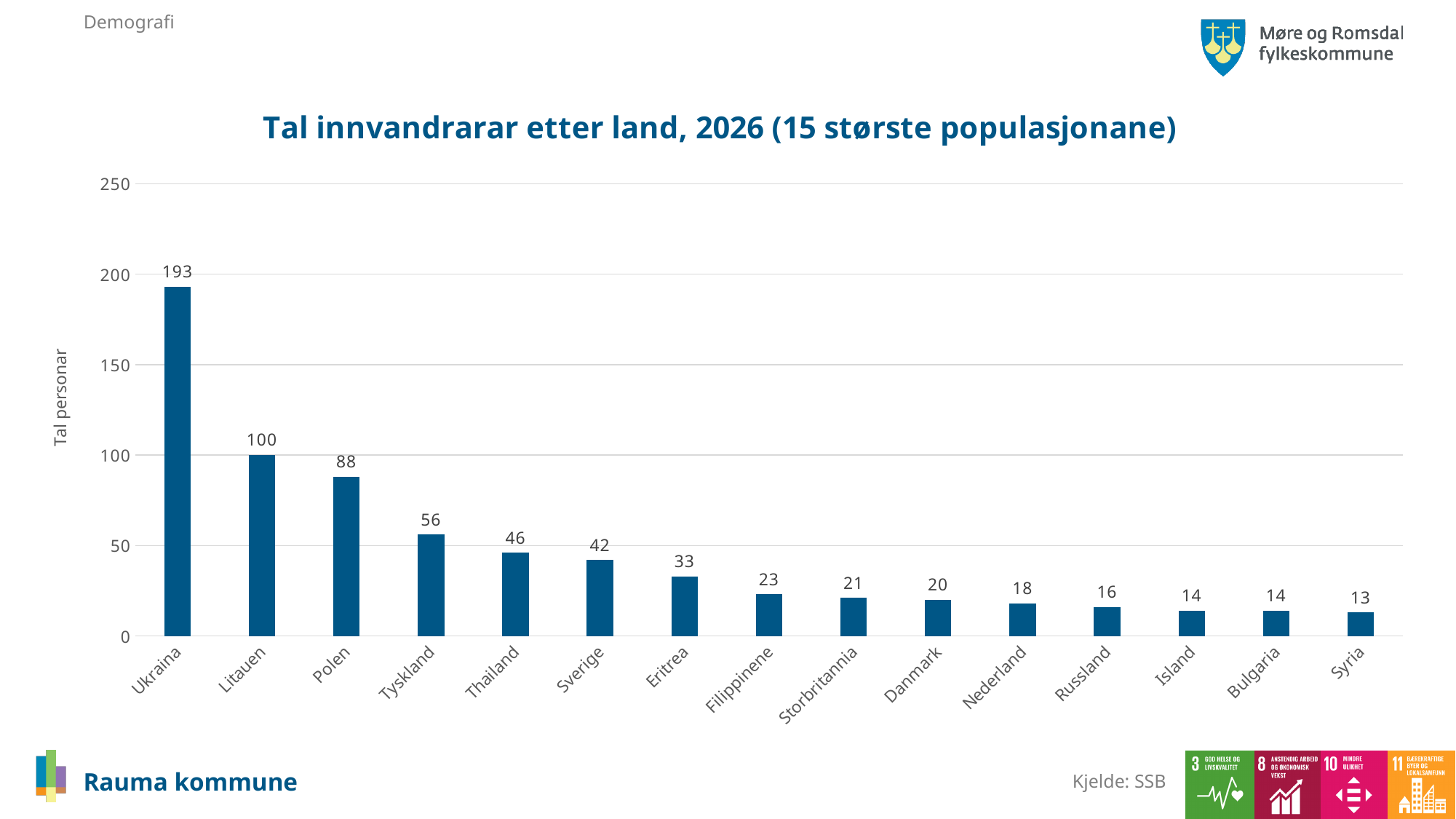
Which country has the lowest value? Syria What is the value for Ukraina? 193 What is the value for Polen? 88 Which country has the highest value? Ukraina What is the value for Eritrea? 33 Which is larger, the value for Tyskland or the value for Thailand? Tyskland What kind of chart is this? bar chart What is the difference between the values for Ukraina and Litauen? 93 Do the values rise or fall from left to right along the x axis? fall What is the title of the chart? Tal innvandrarar etter land, 2026 (15 største populasjonane) Is the value for Sverige greater or less than 50? less How many countries are shown in the chart? 15